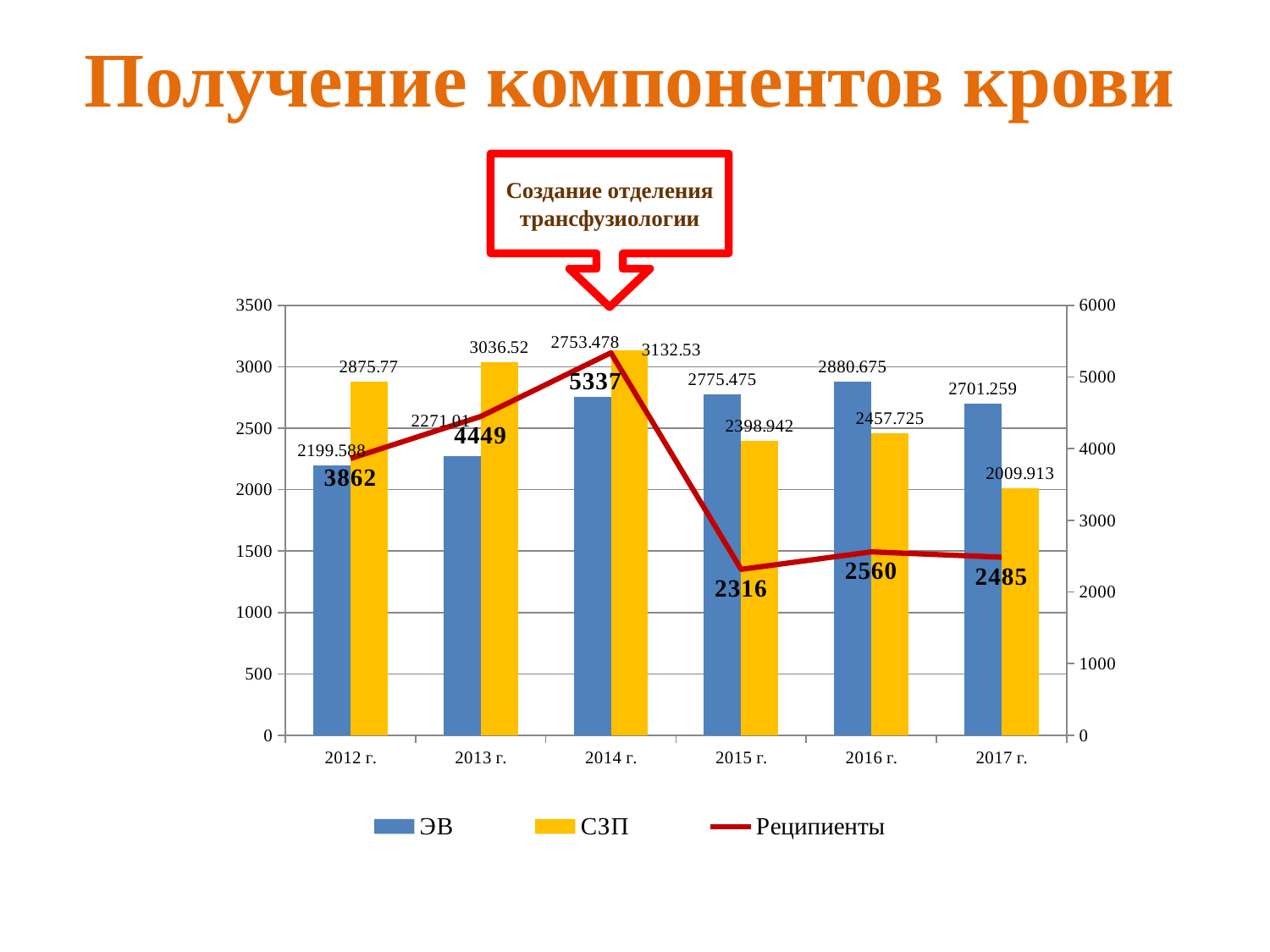
In which year is ЭВ lowest? 2012 г. What kind of chart is this? Combined bar and line chart What is the value of Реципиенты for 2015 г.? 2316 What is the difference between Реципиенты in 2014 г. and 2015 г.? 3021 How many years are shown on the x axis? 6 How many series does the legend list? 3 In which year is СЗП lowest? 2017 г. In which year is Реципиенты highest? 2014 г. What is the value of СЗП for 2014 г.? 3132.53 What is the value of ЭВ for 2016 г.? 2880.675 Does СЗП rise or fall from 2014 г. to 2017 г.? Fall Which is larger in 2013 г., ЭВ or СЗП? СЗП